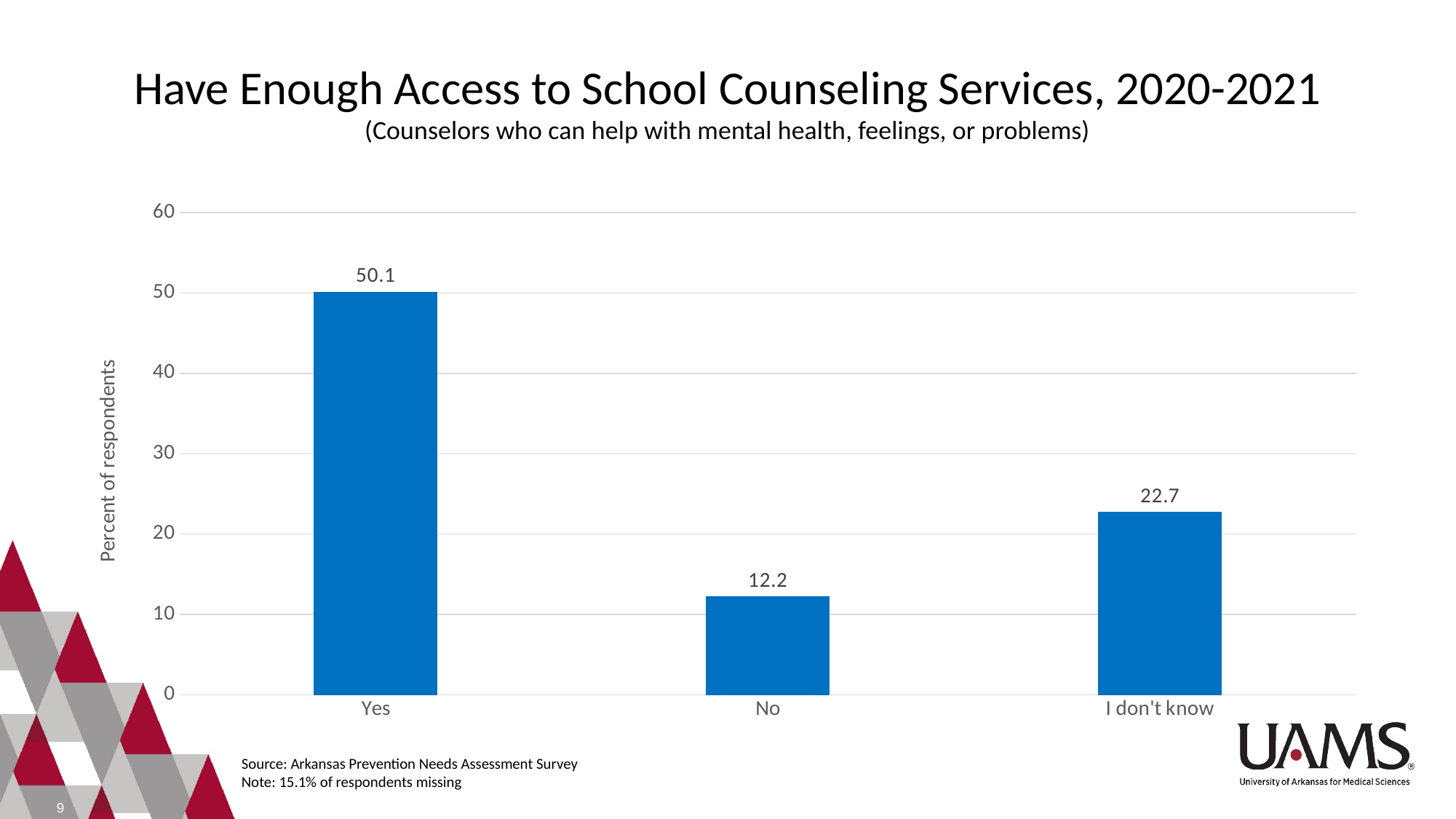
What is the difference in percent of respondents between "I don't know" and "No"? 10.5 Which has a larger percent of respondents, "No" or "I don't know"? I don't know Which response category has the highest percent of respondents? Yes What percent of respondents answered "No"? 12.2 What kind of chart is shown on the slide? Bar chart Is the value for "Yes" greater or less than 40? greater What percent of respondents answered "I don't know"? 22.7 What percent of respondents answered "Yes"? 50.1 How many response categories are shown on the chart? 3 What is the label of the vertical axis? Percent of respondents What is the difference in percent of respondents between "Yes" and "No"? 37.9 Which response category has the lowest percent of respondents? No